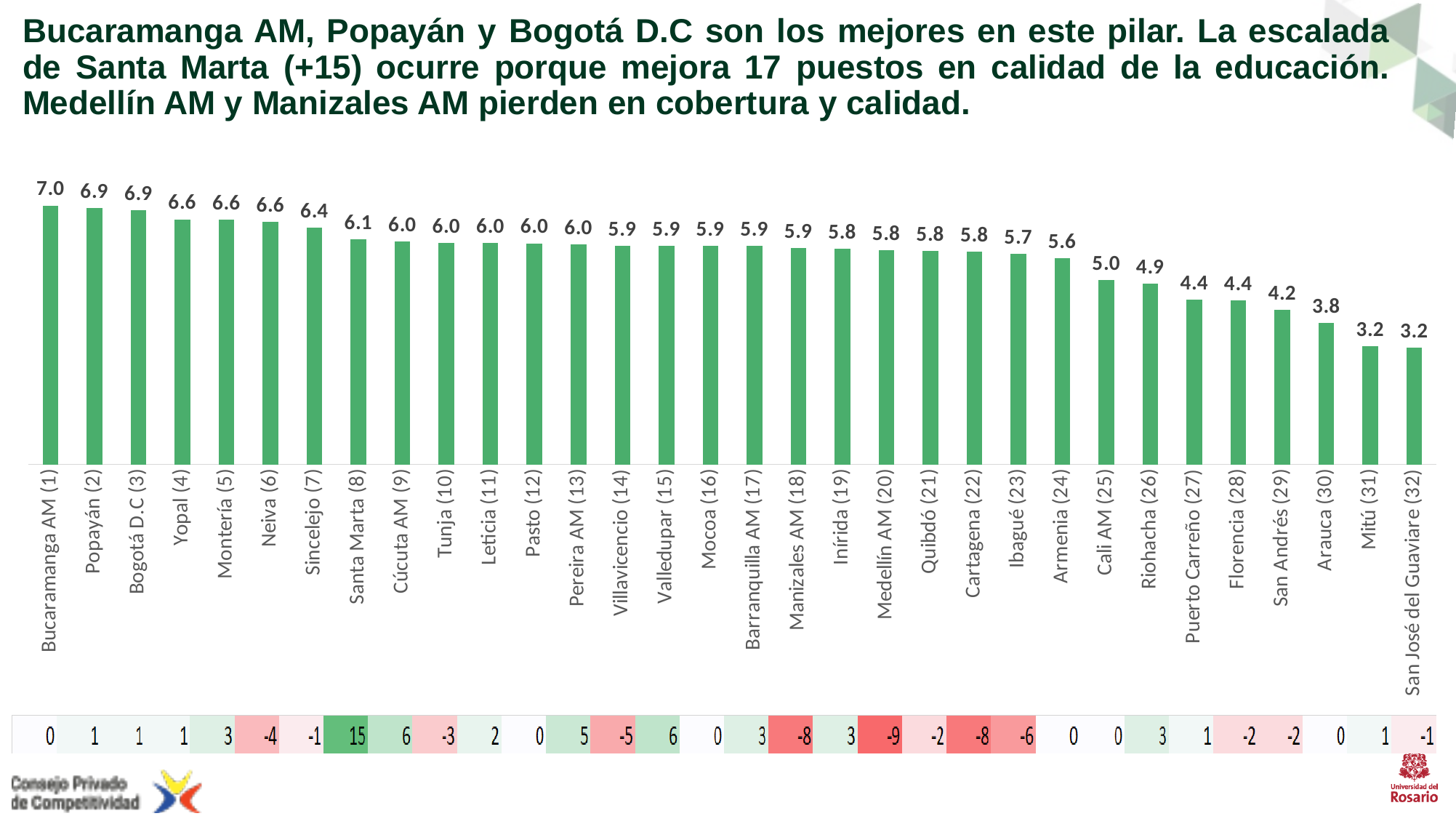
How many cities are shown in the chart? 32 What kind of chart is shown on the slide? Bar chart What is the value for Bucaramanga AM (1)? 7.0 What is the lowest value shown in the chart? 3.2 What is the value for Arauca (30)? 3.8 Which city has the highest value in the chart? Bucaramanga AM (1) What is the value for Cali AM (25)? 5.0 What is the difference between the values for Sincelejo (7) and Riohacha (26)? 1.5 Do the values rise or fall from left to right along the x axis? Fall What is the value for Santa Marta (8)? 6.1 Which has a larger value, Armenia (24) or Florencia (28)? Armenia (24) What is the difference between the values for Bucaramanga AM (1) and San José del Guaviare (32)? 3.8